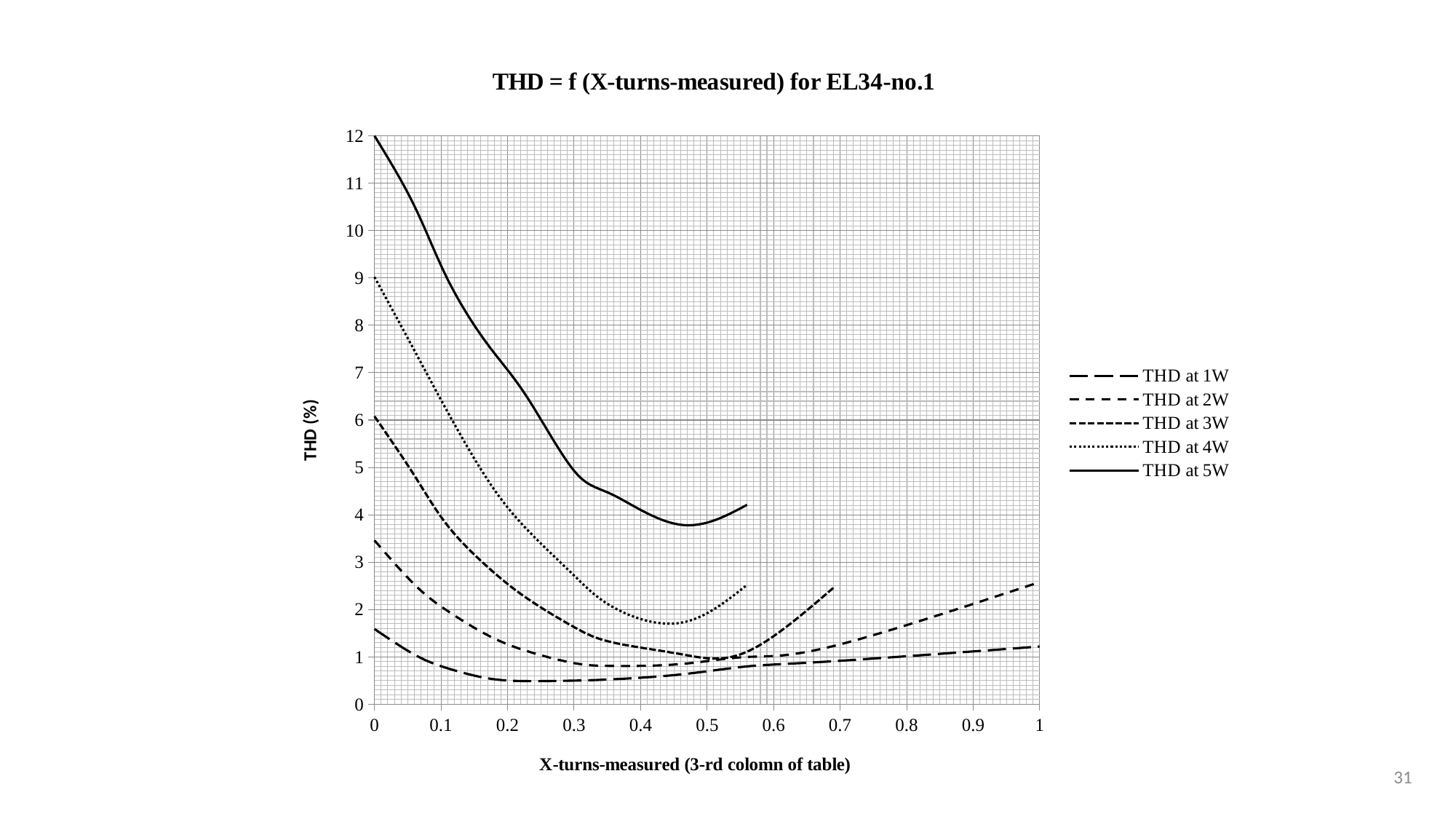
Is the value of THD at 3W at X-turns-measured = 0.1 greater or less than 3? greater What kind of chart is shown on the slide? line chart What is the value of THD at 5W at X-turns-measured = 0? 12 Is the value of THD at 1W at X-turns-measured = 0 greater or less than 2? less What is the title of the chart? THD = f (X-turns-measured) for EL34-no.1 Does THD at 5W rise or fall as X-turns-measured goes from 0 to 0.4? fall What is the label of the vertical axis? THD (%) Which series has the lowest THD at X-turns-measured = 0.2? THD at 1W Which series has the highest THD at X-turns-measured = 0.2? THD at 5W At X-turns-measured = 0, which is higher, THD at 5W or THD at 4W? THD at 5W Is the value of THD at 4W at X-turns-measured = 0.4 greater or less than 3? less How many series does the legend list? 5